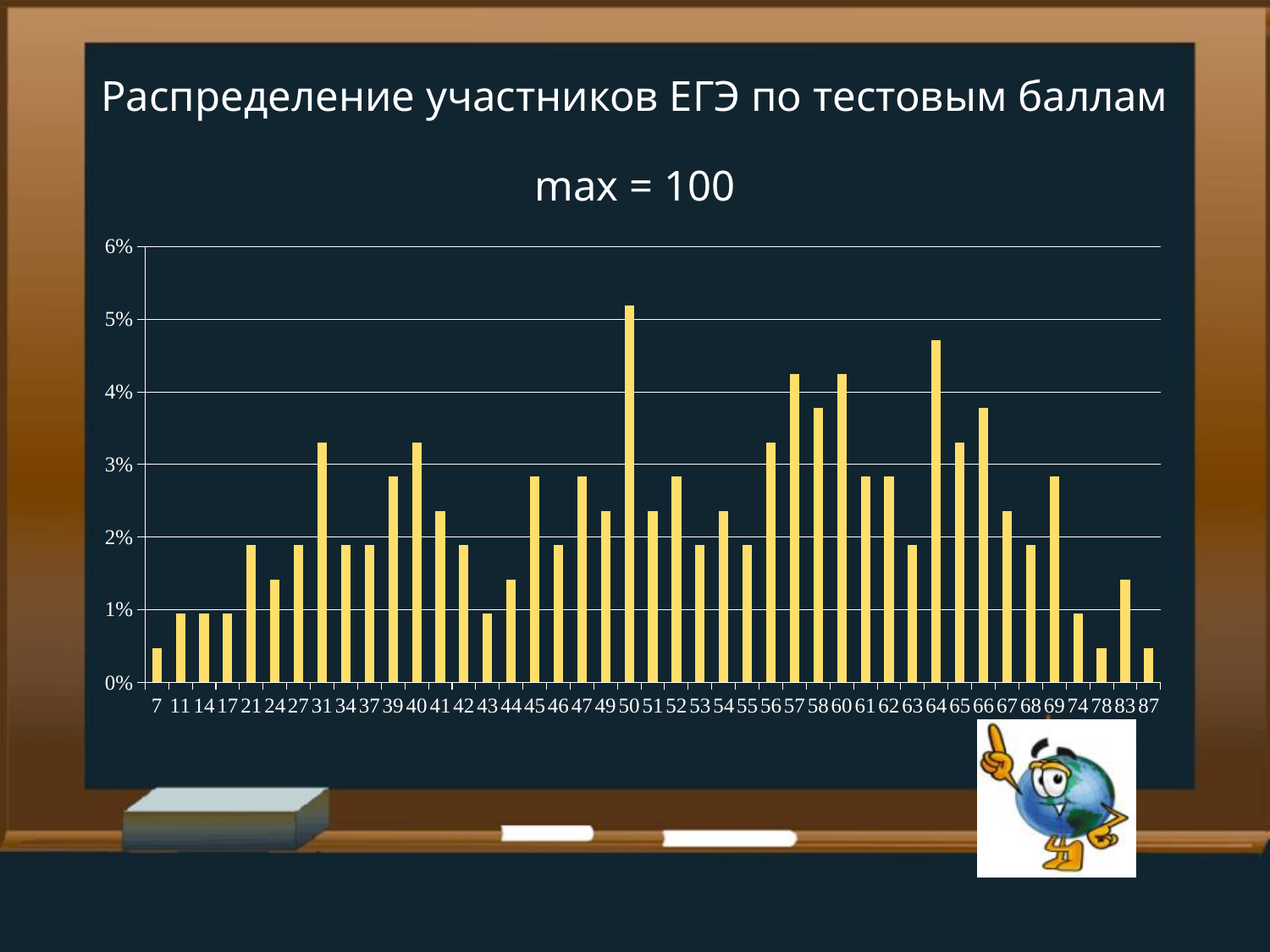
What kind of chart is shown on the slide? bar chart What is the highest value shown on the vertical axis? 6% Is the value for score 58 greater or less than 4%? less Is the value for score 64 greater or less than 4%? greater What is the title of the chart? Распределение участников ЕГЭ по тестовым баллам Which has a larger value, score 7 or score 21? 21 Is the value for score 31 greater or less than 3%? greater Which test score has the highest share of participants? 50 Which has a larger value, score 50 or score 64? 50